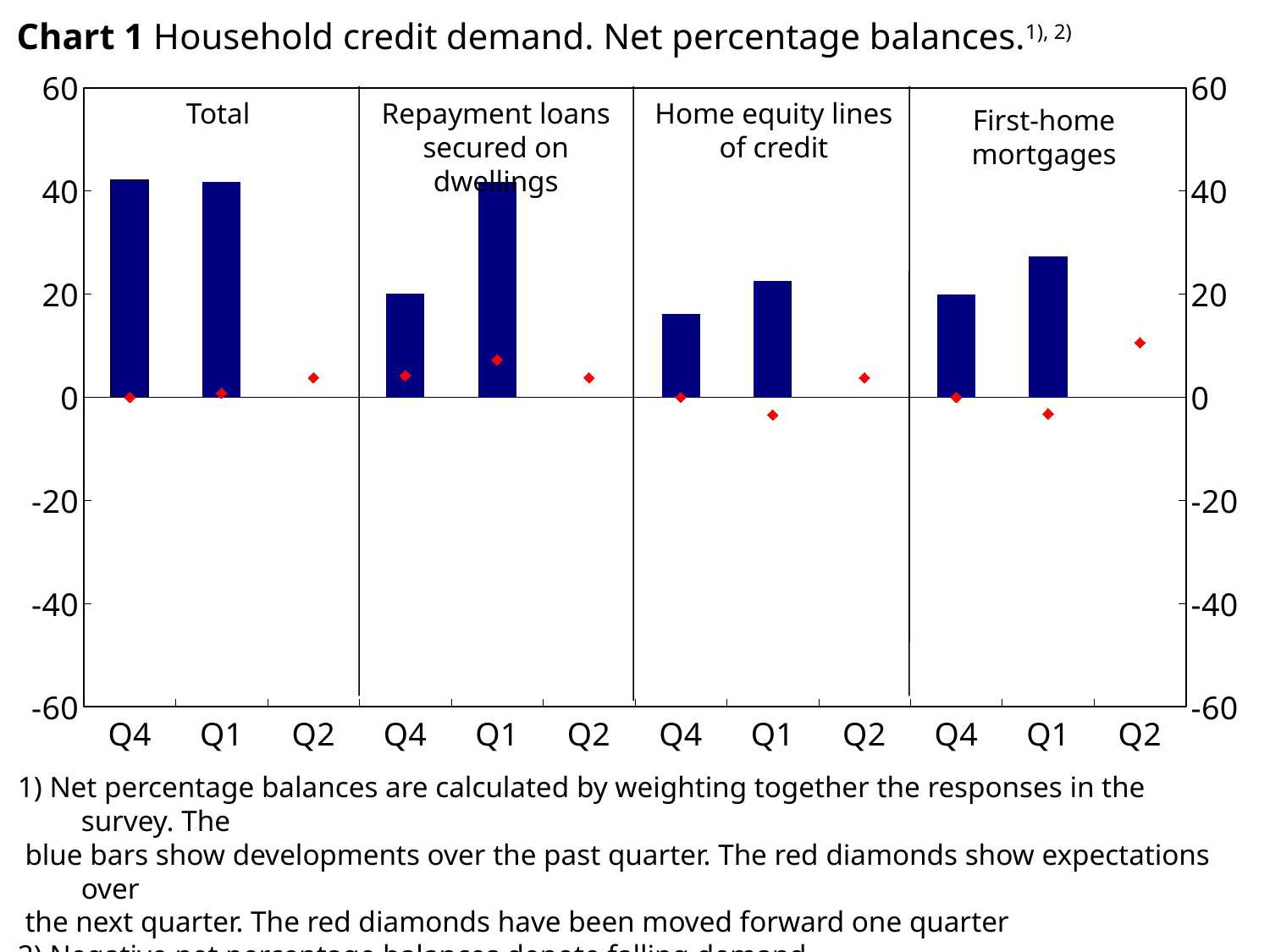
In the First-home mortgages panel, is the Q4 bar or the Q1 bar larger? Q1 Is the Q1 bar for Repayment loans secured on dwellings greater or less than 20? greater Is the Total Q4 bar greater or less than 20? greater How many loan categories (panels) does the chart show? 4 According to the footnote, what do the red diamonds show? Expectations over the next quarter In the Home equity lines of credit panel, is the Q4 bar or the Q1 bar larger? Q1 Which panel has the lowest Q4 bar? Home equity lines of credit What kind of chart is shown on the slide? bar chart How many quarters are labelled on the x axis within each panel? 3 Is the Q4 bar for Home equity lines of credit greater or less than 20? less In the Repayment loans secured on dwellings panel, is the Q4 bar or the Q1 bar larger? Q1 Do the bars in the First-home mortgages panel rise or fall from Q4 to Q1? rise